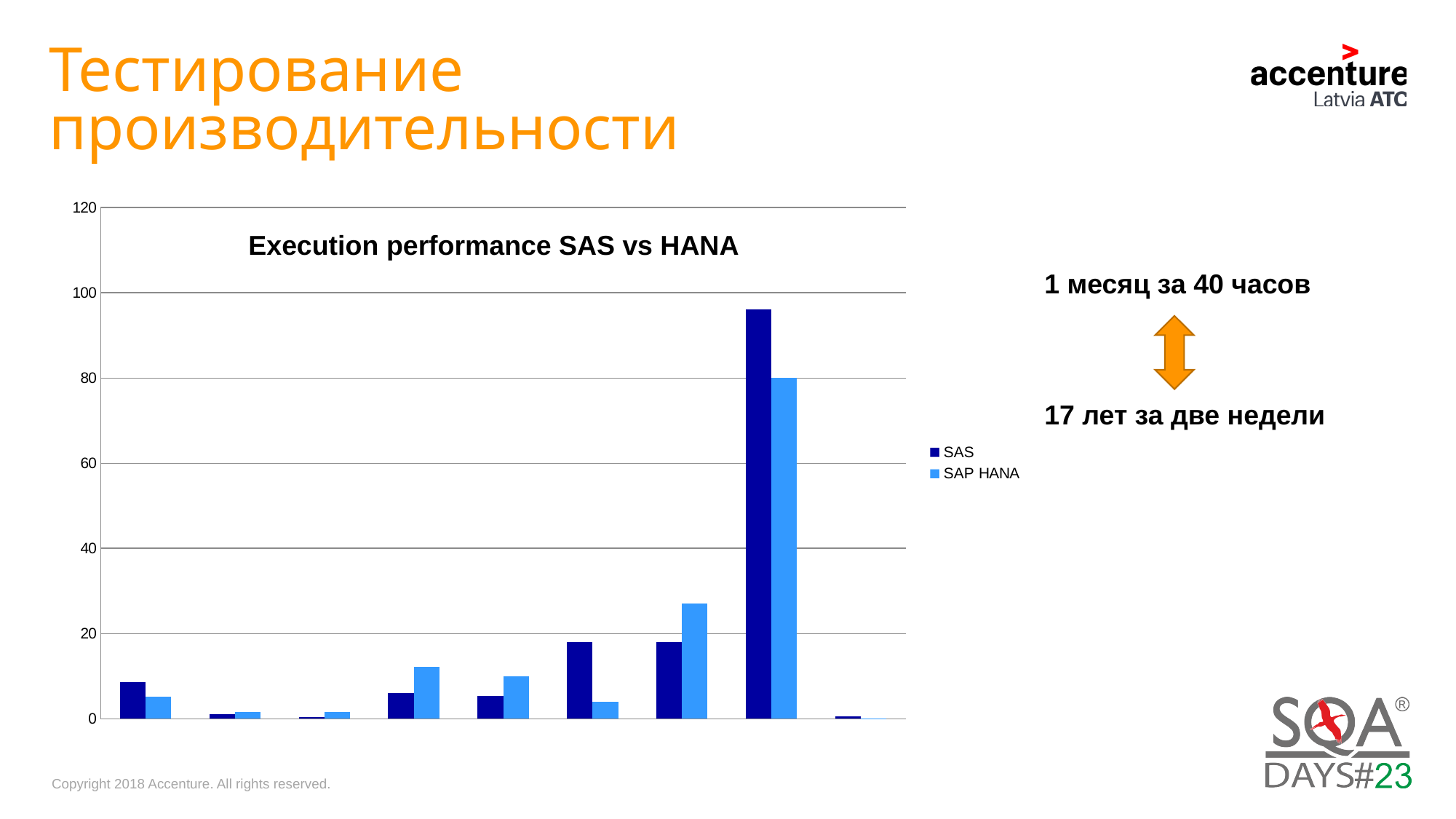
Which series has the tallest bar in the chart? SAS Which two series are listed in the chart legend? SAS and SAP HANA In the tallest group of bars (eighth from the left), which is larger, SAS or SAP HANA? SAS What kind of chart is shown on the slide? bar chart Is the SAP HANA value in the seventh group from the left greater or less than 20? greater How many groups of bars are plotted along the x axis of the chart? 9 In the seventh group of bars from the left, which is larger, SAS or SAP HANA? SAP HANA Is the tallest SAP HANA bar greater or less than 60? greater What is the title of the chart? Execution performance SAS vs HANA Is the tallest SAS bar greater or less than 80? greater How many series does the legend of the chart list? 2 What is the highest value shown on the vertical axis of the chart? 120